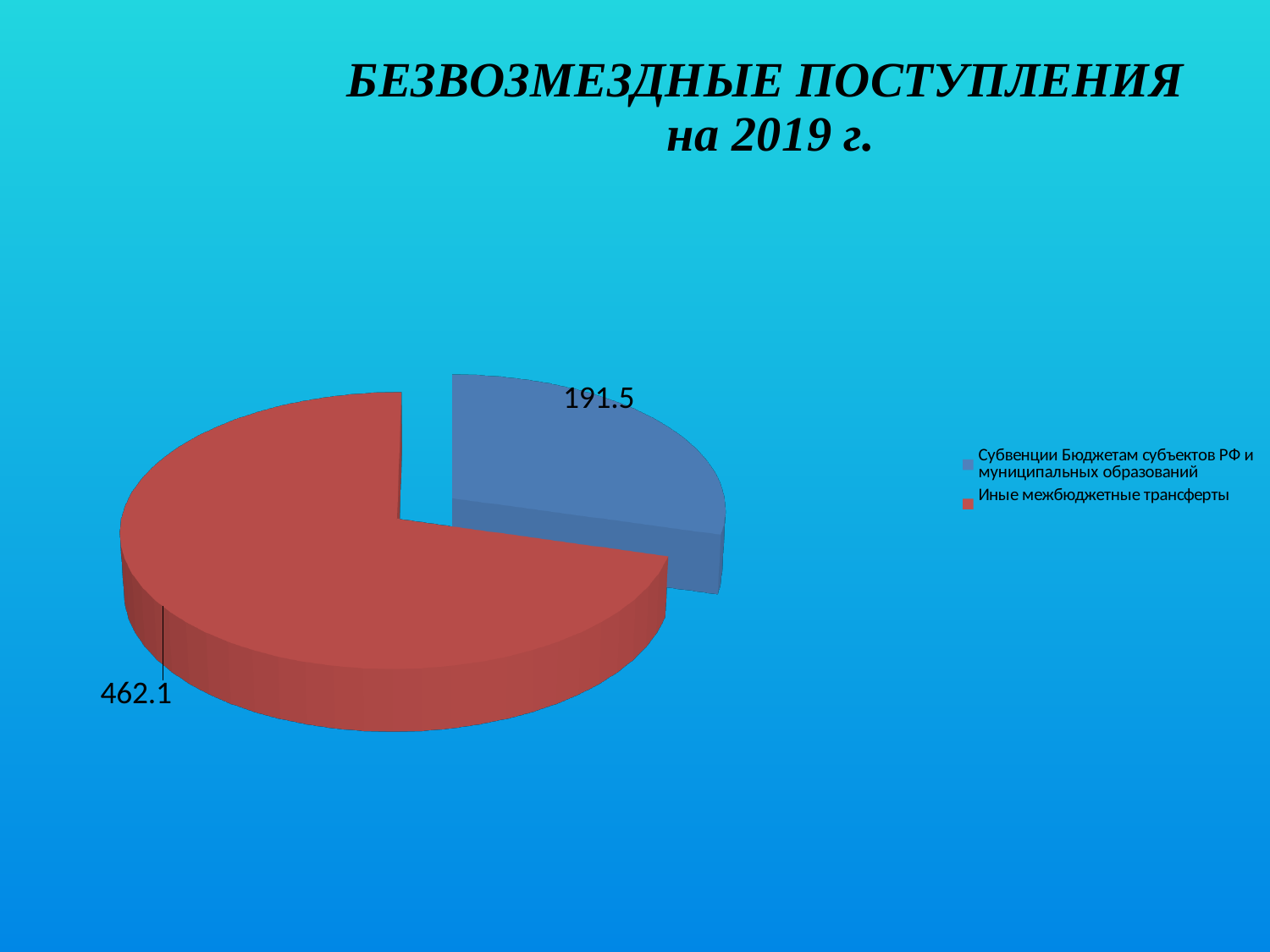
Which category has the smallest slice of the pie? Субвенции Бюджетам субъектов РФ и муниципальных образований How many slices does the pie chart have? 2 What is the total of the two values shown on the pie chart? 653.6 Which category has the largest slice of the pie? Иные межбюджетные трансферты What is the value for Субвенции Бюджетам субъектов РФ и муниципальных образований? 191.5 How many entries does the legend list? 2 Which is larger: Иные межбюджетные трансферты or Субвенции Бюджетам субъектов РФ и муниципальных образований? Иные межбюджетные трансферты What colour is the slice for Иные межбюджетные трансферты? red What is the title of the slide? БЕЗВОЗМЕЗДНЫЕ ПОСТУПЛЕНИЯ на 2019 г. What is the difference between the value for Иные межбюджетные трансферты and the value for Субвенции Бюджетам субъектов РФ и муниципальных образований? 270.6 What type of chart is shown on the slide? pie chart What is the value for Иные межбюджетные трансферты? 462.1